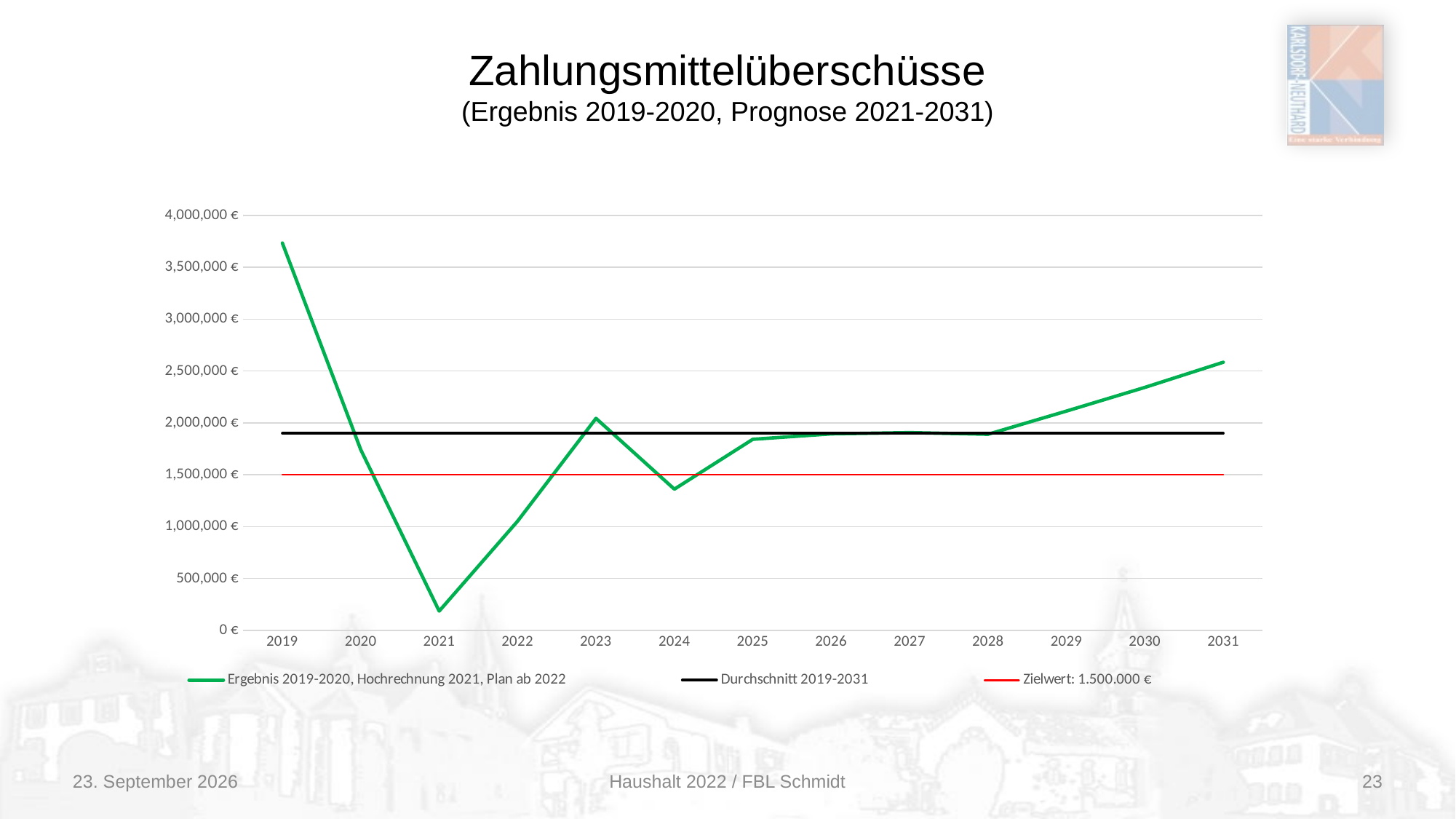
Is the value of the green line for 2021 greater or less than 500,000 €? less In which year is the green line (Ergebnis/Hochrechnung/Plan) at its highest? 2019 Which year has the larger value on the green line, 2023 or 2024? 2023 What target value (Zielwert) is stated in the legend for the red line? 1.500.000 € Is the value of the green line for 2024 greater or less than 1,500,000 €? less Is the value of the green line for 2031 greater or less than 2,500,000 €? greater How many series does the legend list? 3 How many years are shown on the x axis? 13 In which year is the green line (Ergebnis/Hochrechnung/Plan) at its lowest? 2021 What kind of chart is shown on the slide? line chart Does the green line rise or fall from 2028 to 2031? rise